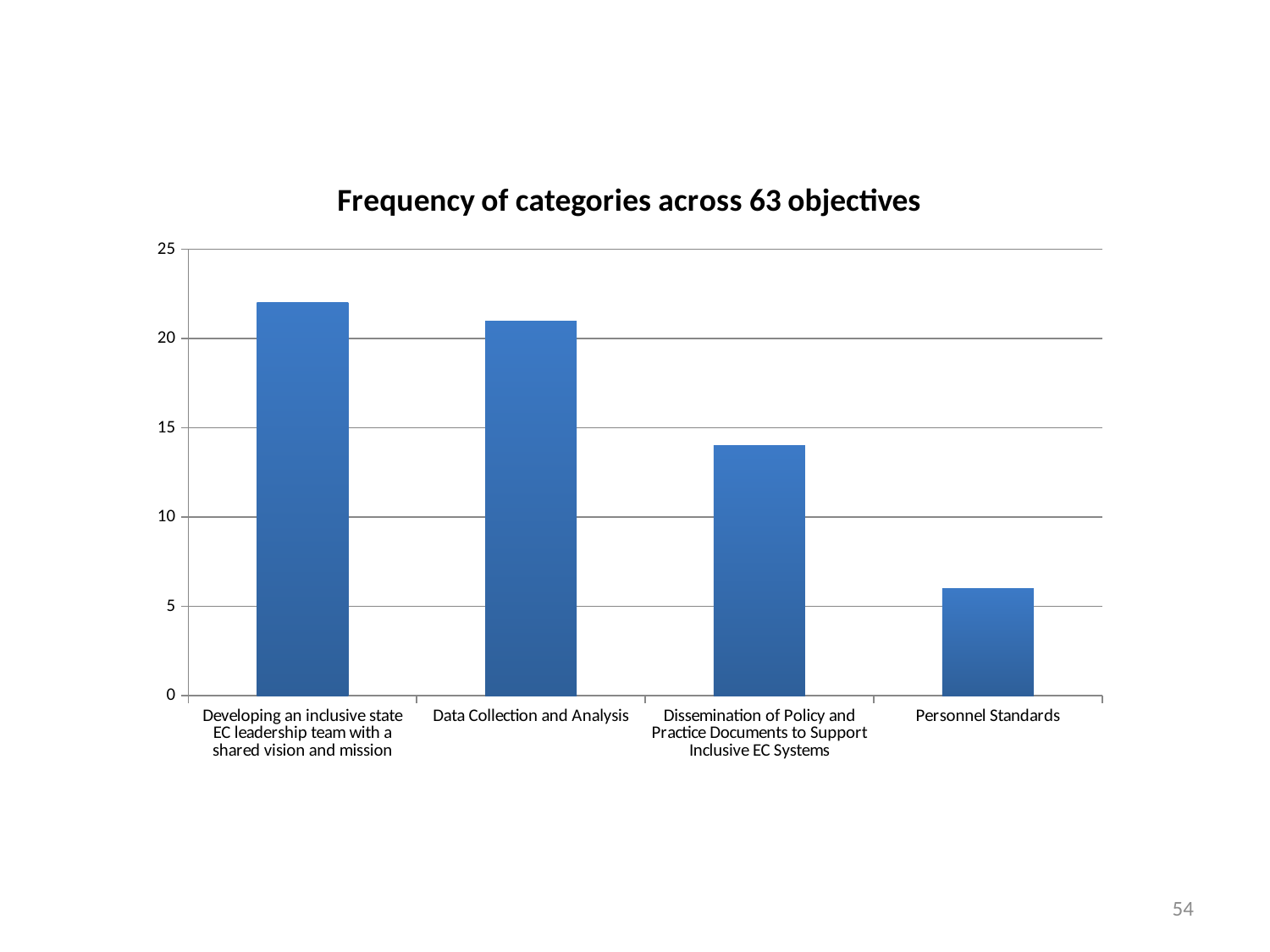
Which category has the lowest value? Personnel Standards What is the title of the chart? Frequency of categories across 63 objectives How many categories are shown on the x axis? 4 Is the value for Data Collection and Analysis greater or less than 20? greater Which is larger: the value for Data Collection and Analysis or the value for Dissemination of Policy and Practice Documents to Support Inclusive EC Systems? Data Collection and Analysis Is the value for Dissemination of Policy and Practice Documents to Support Inclusive EC Systems greater or less than 15? less Is the value for Personnel Standards greater or less than 5? greater What kind of chart is shown on the slide? bar chart Do the values rise or fall from left to right along the x axis? fall Which is larger: the value for Dissemination of Policy and Practice Documents to Support Inclusive EC Systems or the value for Personnel Standards? Dissemination of Policy and Practice Documents to Support Inclusive EC Systems